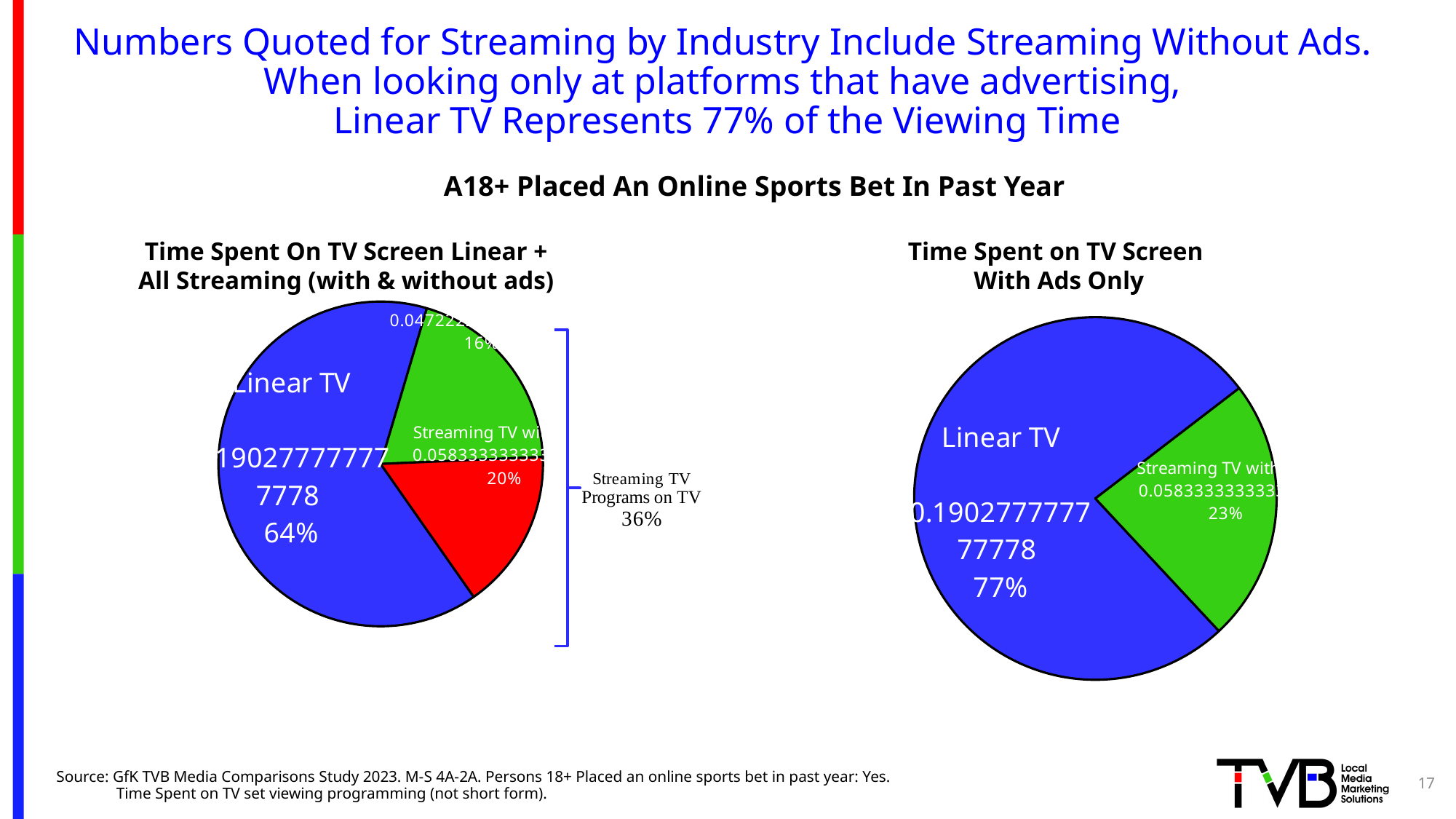
In the left chart, which slice is the largest? Linear TV In the 'Time Spent on TV Screen With Ads Only' chart, what share of viewing time does Linear TV represent? 77% In the left chart, what combined share is shown by the bracket for Streaming TV Programs on TV? 36% Is the Linear TV share larger in the left chart or the right chart? Right chart How many slices does the 'Time Spent on TV Screen With Ads Only' pie chart have? 2 In the right chart, what is the difference in percentage points between the Linear TV share and the Streaming TV with ads share? 54 How many slices does the left pie chart have? 3 What audience subtitle appears above the two pie charts? A18+ Placed An Online Sports Bet In Past Year What kind of charts are shown on the slide? Pie charts In the 'Time Spent on TV Screen With Ads Only' chart, what share does Streaming TV with ads represent? 23% In the 'Time Spent On TV Screen Linear + All Streaming (with & without ads)' chart, what share does Linear TV represent? 64% In the 'Time Spent on TV Screen With Ads Only' chart, which slice is the largest? Linear TV